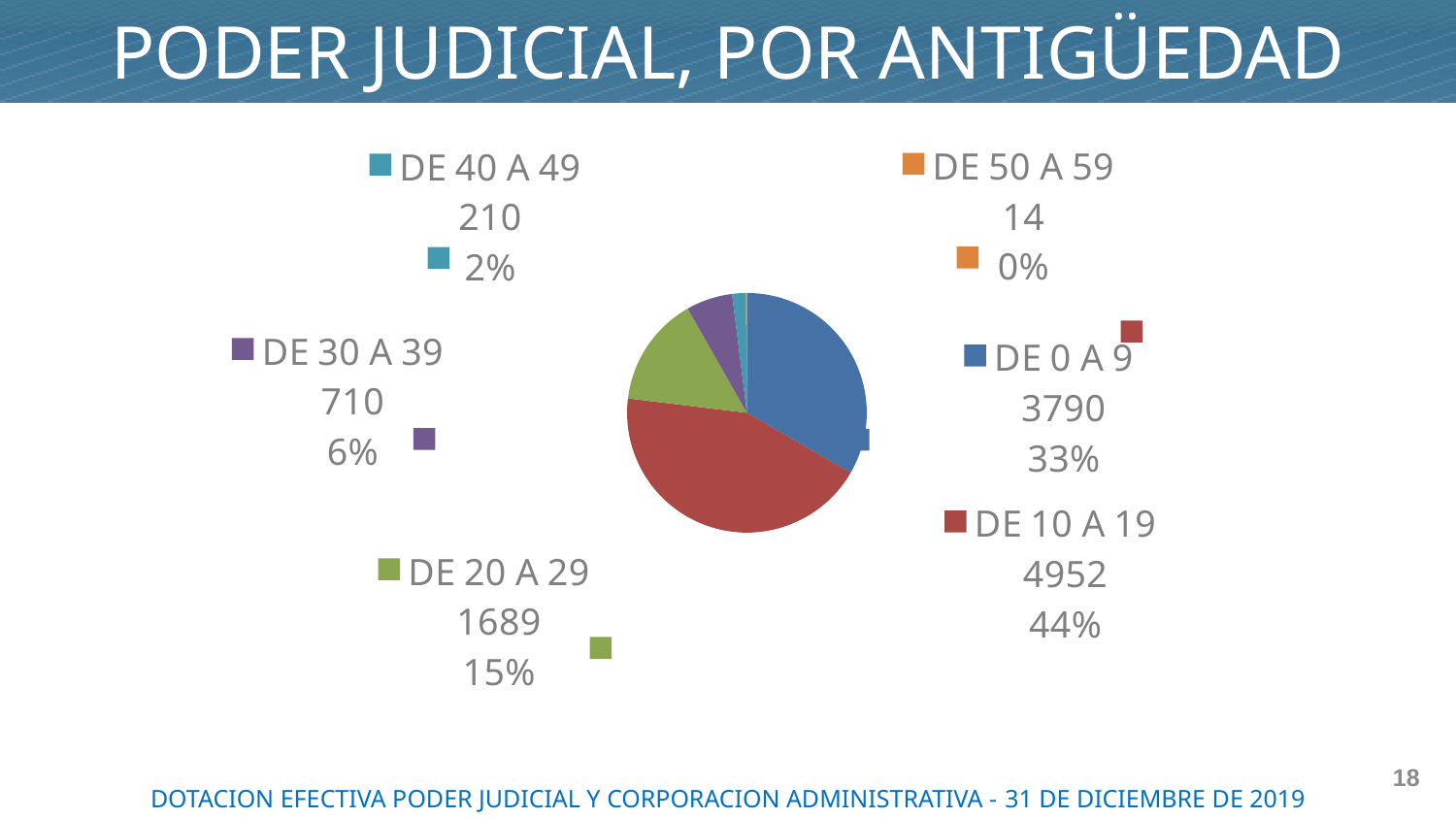
What share of the pie does DE 10 A 19 represent? 44% What share of the pie does DE 30 A 39 represent? 6% What is the difference between the values for DE 10 A 19 and DE 0 A 9? 1162 What is the value for DE 0 A 9? 3790 What is the value for DE 10 A 19? 4952 What is the value for DE 20 A 29? 1689 Which category has the lowest value? DE 50 A 59 How many categories does the pie chart show? 6 Which is larger, the value for DE 30 A 39 or DE 40 A 49? DE 30 A 39 What kind of chart is shown on the slide? pie chart What is the value for DE 50 A 59? 14 Which category has the highest value? DE 10 A 19